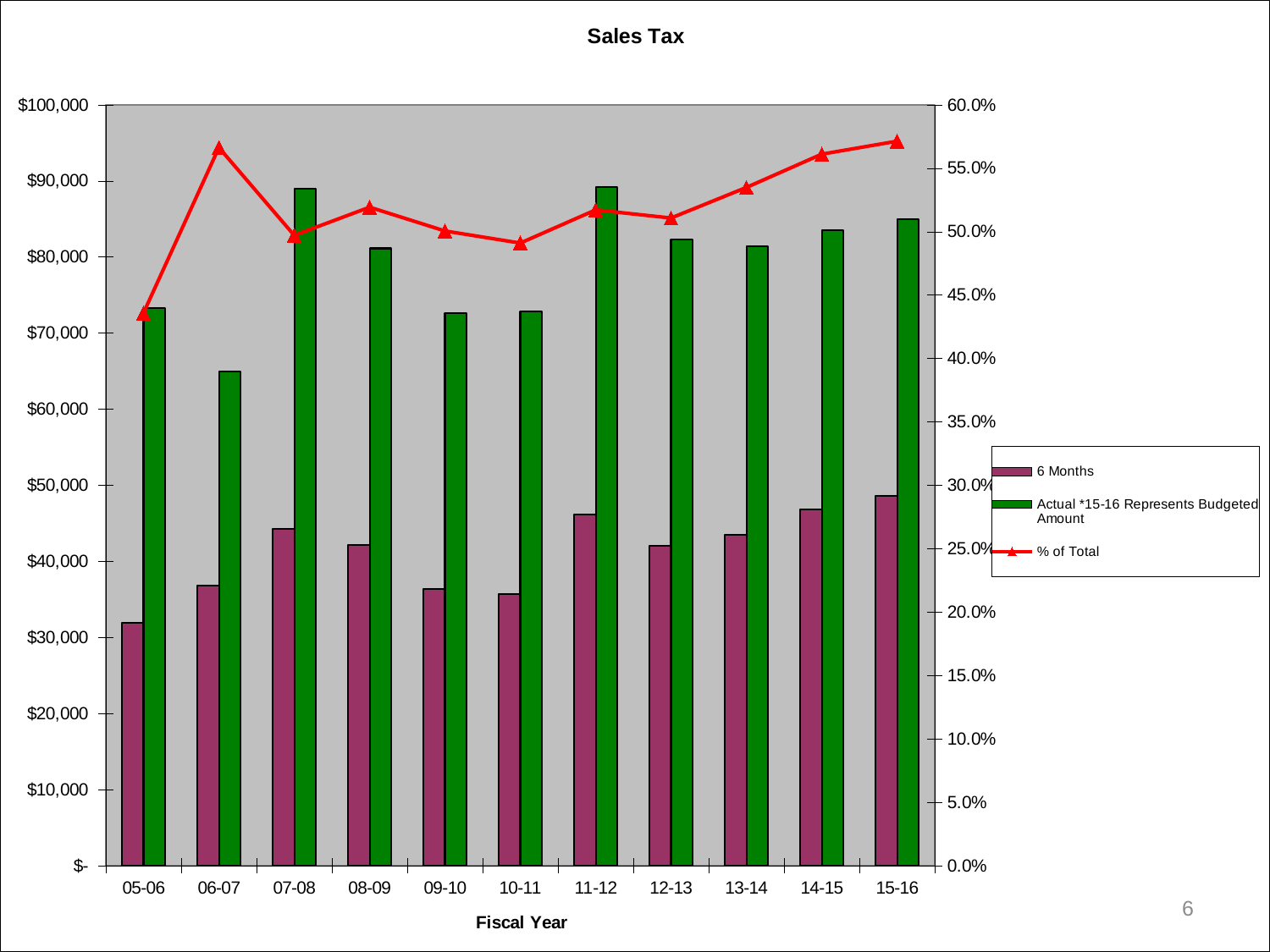
How many fiscal years are shown on the x axis? 11 Is the Actual value for 06-07 greater or less than $70,000? less What is the title of the chart? Sales Tax Which is larger, the 6 Months value for 11-12 or for 09-10? 11-12 Which fiscal year has the lowest % of Total value? 05-06 Is the Actual value for 07-08 greater or less than $80,000? greater Which fiscal year has the lowest 6 Months value? 05-06 Is the % of Total value for 05-06 greater or less than 45.0%? less Does the % of Total line rise or fall from 10-11 to 15-16? rise How many series does the legend list? 3 Which fiscal year has the lowest Actual value? 06-07 What is the label of the x axis? Fiscal Year